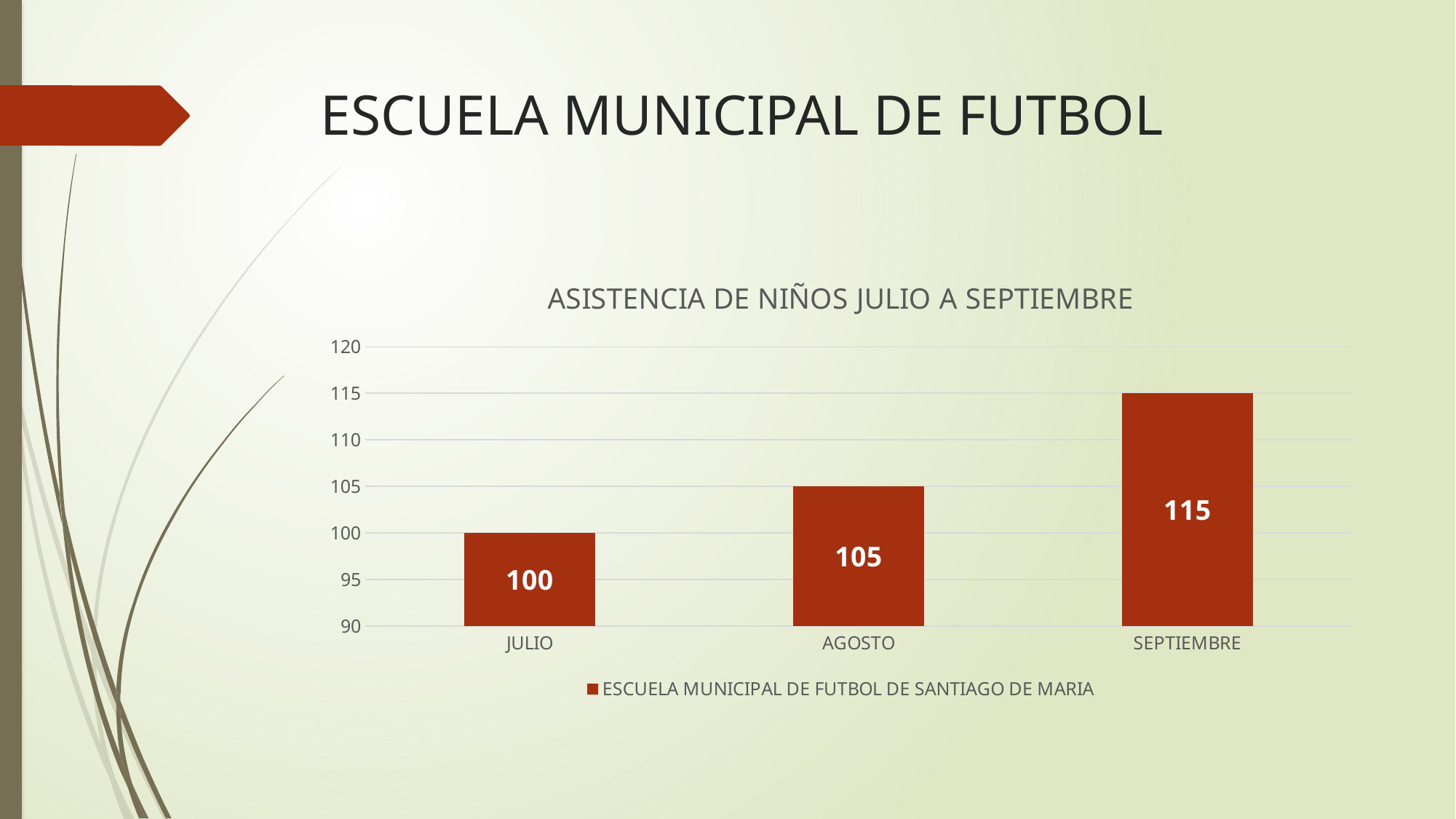
What is the value for SEPTIEMBRE? 115 What is the difference between the values for SEPTIEMBRE and JULIO? 15 Is the value for SEPTIEMBRE greater or less than 110? greater Which is larger, the value for AGOSTO or the value for SEPTIEMBRE? SEPTIEMBRE What is the difference between the values for AGOSTO and JULIO? 5 What is the value for JULIO? 100 What kind of chart is shown on the slide? bar chart Do the values rise or fall from JULIO to SEPTIEMBRE? rise Which month has the lowest value? JULIO What is the value for AGOSTO? 105 Which month has the highest value? SEPTIEMBRE How many months are shown on the x axis? 3